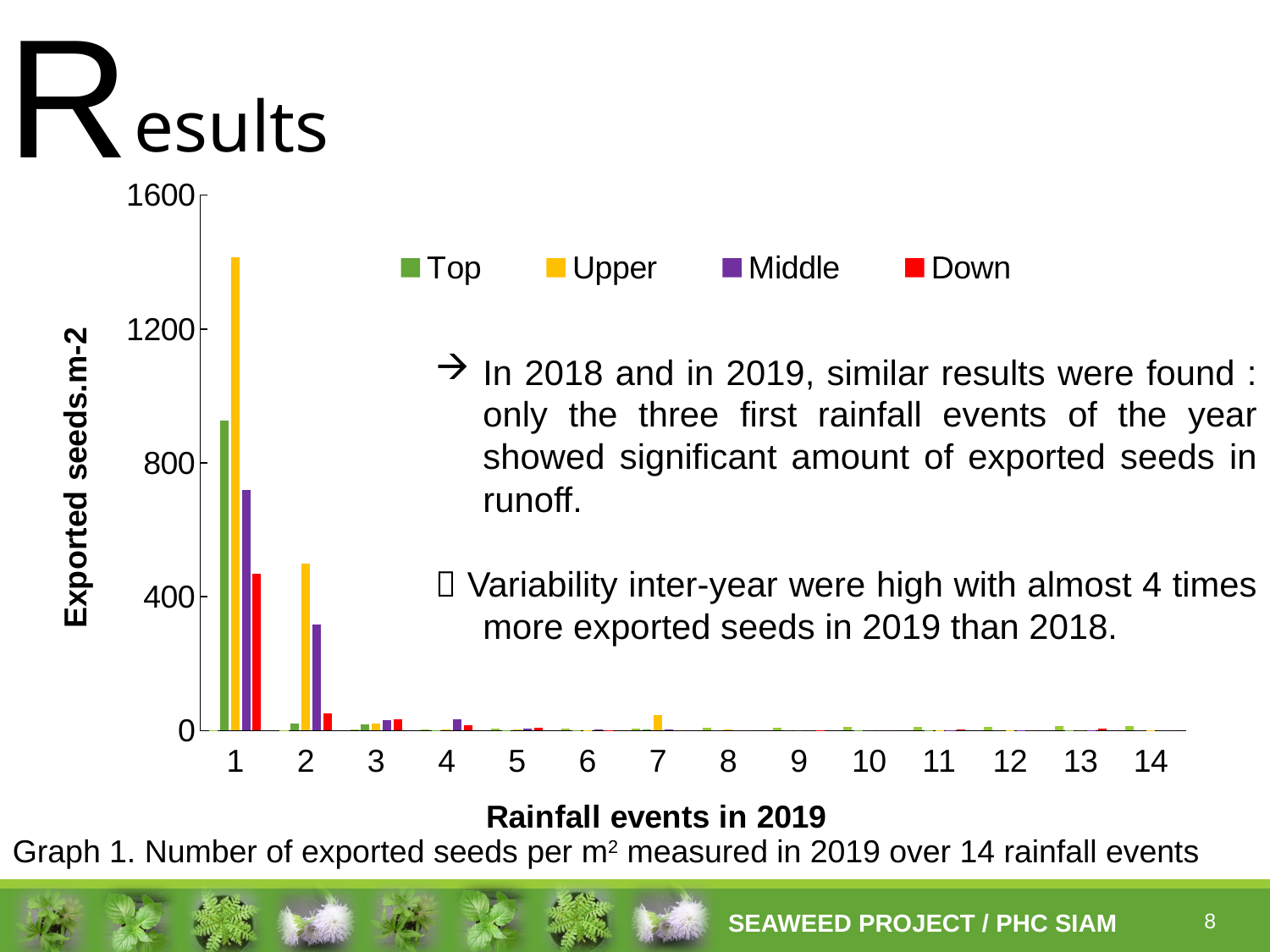
What kind of chart is shown on the slide? bar chart Is the value for Top at rainfall event 1 greater or less than 800? greater Do the exported seed values generally rise or fall from rainfall event 1 to rainfall event 14? fall Is the value for Upper at rainfall event 1 greater or less than 1200? greater How many series does the legend list? 4 For the Upper series, which rainfall event has the highest value? 1 At rainfall event 1, which is larger: the Top value or the Middle value? Top Which series has the highest value for rainfall event 1? Upper How many rainfall events are shown on the x axis? 14 Is the value for Upper at rainfall event 2 greater or less than 400? greater What is the title of the y axis? Exported seeds.m-2